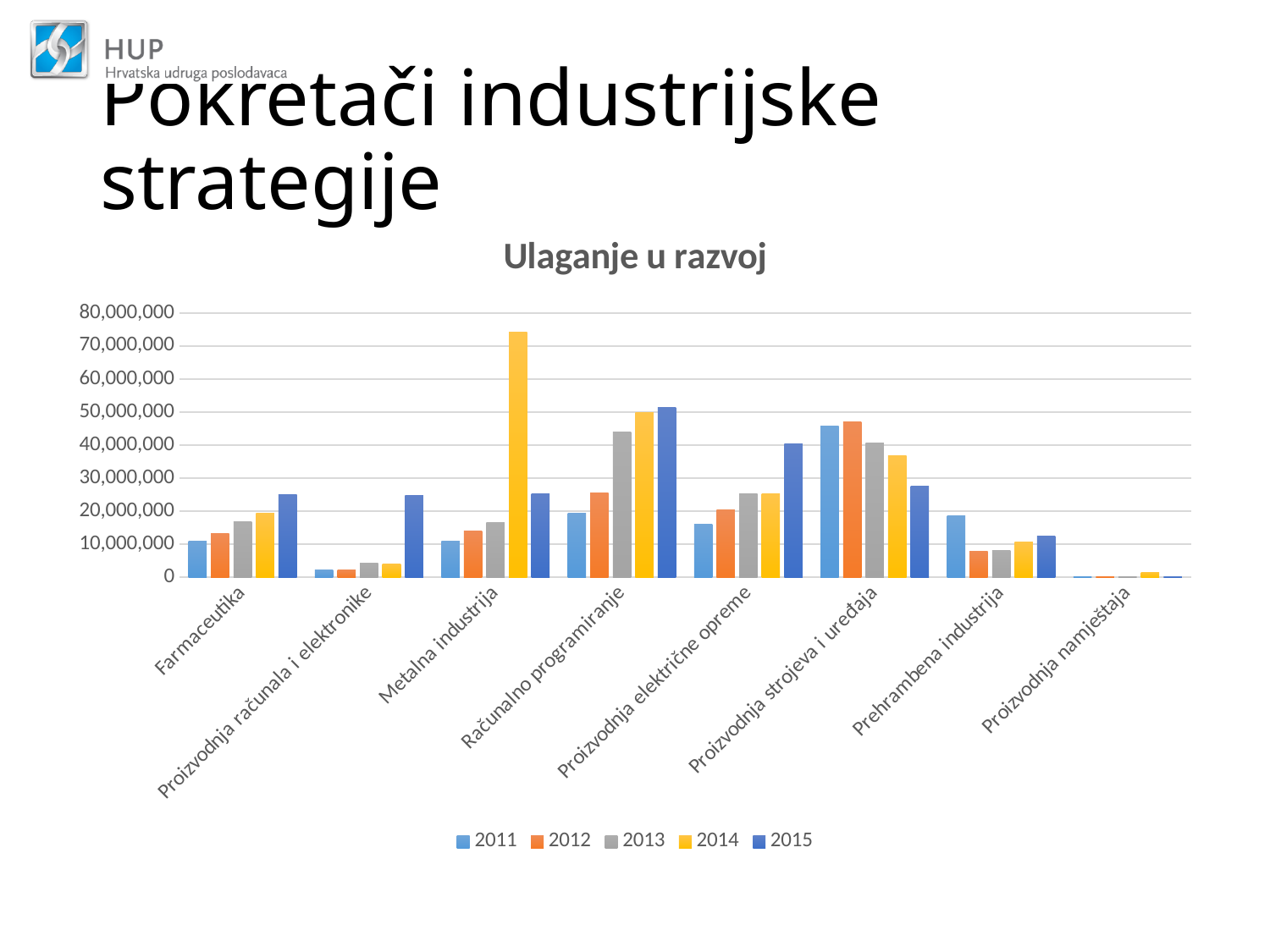
Which category has the lowest values overall? Proizvodnja namještaja Is the value for Prehrambena industrija in 2011 greater or less than 20,000,000? less What is the title of the chart? Ulaganje u razvoj Is the value for Metalna industrija in 2014 greater or less than 70,000,000? greater What kind of chart is shown on the slide? Bar chart Do the values for Farmaceutika rise or fall from 2011 to 2015? rise Is the value for Proizvodnja računala i elektronike in 2015 greater or less than 20,000,000? greater How many series does the legend list? 5 Which category and year has the highest bar in the chart? Metalna industrija, 2014 How many industry categories are shown on the x axis? 8 For Proizvodnja strojeva i uređaja, which year has the larger value, 2011 or 2015? 2011